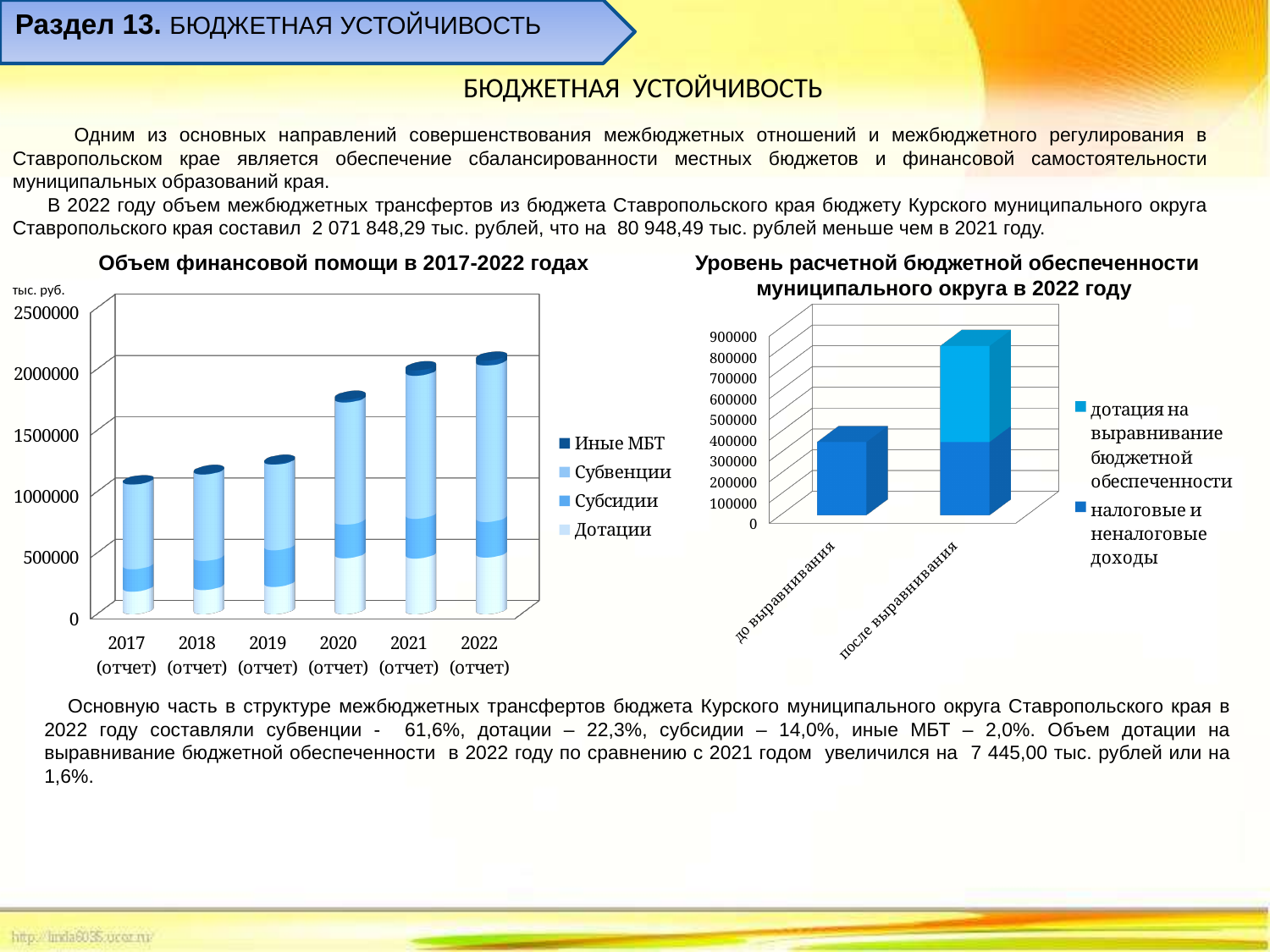
In the 'Объем финансовой помощи в 2017-2022 годах' chart, which year has the shortest stacked bar? 2017 (отчет) In the 'Уровень расчетной бюджетной обеспеченности муниципального округа в 2022 году' chart, which category has the taller bar? после выравнивания In the 'Объем финансовой помощи в 2017-2022 годах' chart, is the total for 2020 (отчет) greater or less than 1500000? greater In the 'Объем финансовой помощи в 2017-2022 годах' chart, is the total for 2022 (отчет) greater or less than 2000000? greater In the 'Объем финансовой помощи в 2017-2022 годах' chart, which year has the tallest stacked bar? 2022 (отчет) In the 'Объем финансовой помощи в 2017-2022 годах' chart, which series is listed first in the legend? Иные МБТ How many years are shown on the x axis of the 'Объем финансовой помощи в 2017-2022 годах' chart? 6 How many series does the legend of the 'Уровень расчетной бюджетной обеспеченности муниципального округа в 2022 году' chart list? 2 How many series does the legend of the 'Объем финансовой помощи в 2017-2022 годах' chart list? 4 In the 'Объем финансовой помощи в 2017-2022 годах' chart, do the stacked bar totals rise or fall from 2017 to 2022? rise What kind of chart is the 'Объем финансовой помощи в 2017-2022 годах' chart? bar chart